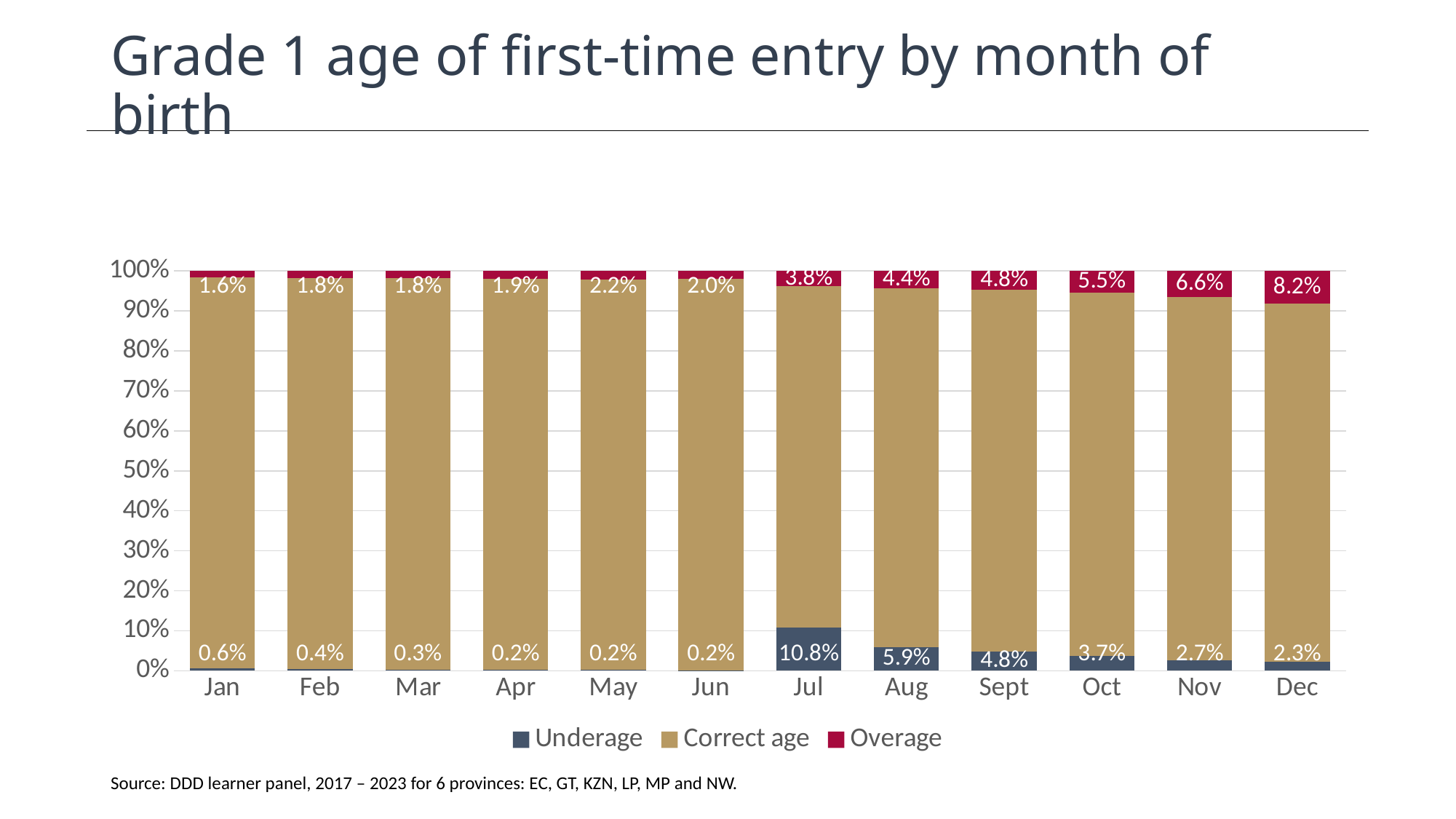
How many series does the legend list? 3 What is the Overage share for Dec? 8.2% Which month has the highest Overage share? Dec What is the difference between the Overage share for Dec and the Overage share for Jan? 6.6% Which month has the highest Underage share? Jul What is the Overage share for Jan? 1.6% What is the Underage share for Jul? 10.8% How many months are shown on the x axis? 12 Which is larger, the Underage share for Aug or the Underage share for Sept? Aug What kind of chart is shown on the slide? Stacked bar chart Which month has the lowest Overage share? Jan Is the Correct age share for Jul greater or less than 80%? greater